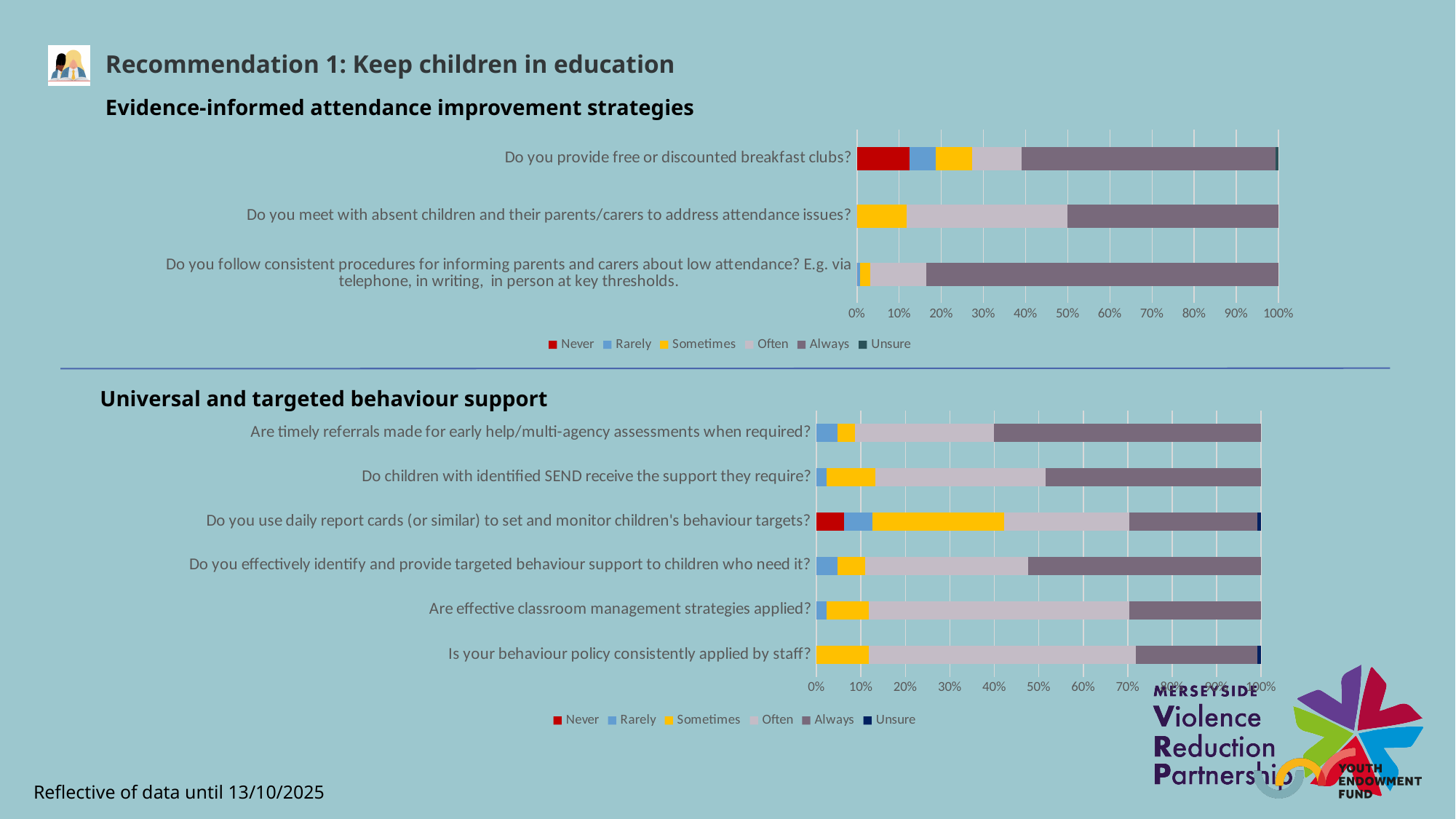
How many questions (categories) are plotted in the 'Universal and targeted behaviour support' chart? 6 In the 'Evidence-informed attendance improvement strategies' chart, which question is the only one with a 'Never' segment? Do you provide free or discounted breakfast clubs? In the 'Universal and targeted behaviour support' chart, which question has the largest 'Sometimes' segment? Do you use daily report cards (or similar) to set and monitor children's behaviour targets? How many series does the legend of the 'Universal and targeted behaviour support' chart list? 6 In the 'Evidence-informed attendance improvement strategies' chart, which response option is shown in red in the legend? Never In the 'Evidence-informed attendance improvement strategies' chart, which question has the largest 'Always' segment? Do you follow consistent procedures for informing parents and carers about low attendance? E.g. via telephone, in writing, in person at key thresholds. In the 'Universal and targeted behaviour support' chart, which has the larger 'Always' segment: 'Are timely referrals made for early help/multi-agency assessments when required?' or 'Are effective classroom management strategies applied?' Are timely referrals made for early help/multi-agency assessments when required? In the 'Evidence-informed attendance improvement strategies' chart, is the 'Always' share for 'Do you follow consistent procedures for informing parents and carers about low attendance?' greater or less than 50%? greater What kind of chart is the 'Evidence-informed attendance improvement strategies' chart? Stacked bar chart In the 'Universal and targeted behaviour support' chart, is the 'Sometimes' share for 'Do you use daily report cards (or similar) to set and monitor children's behaviour targets?' greater or less than 20%? greater How many questions (categories) are plotted in the 'Evidence-informed attendance improvement strategies' chart? 3 In the 'Universal and targeted behaviour support' chart, is the 'Often' share for 'Is your behaviour policy consistently applied by staff?' greater or less than 50%? greater